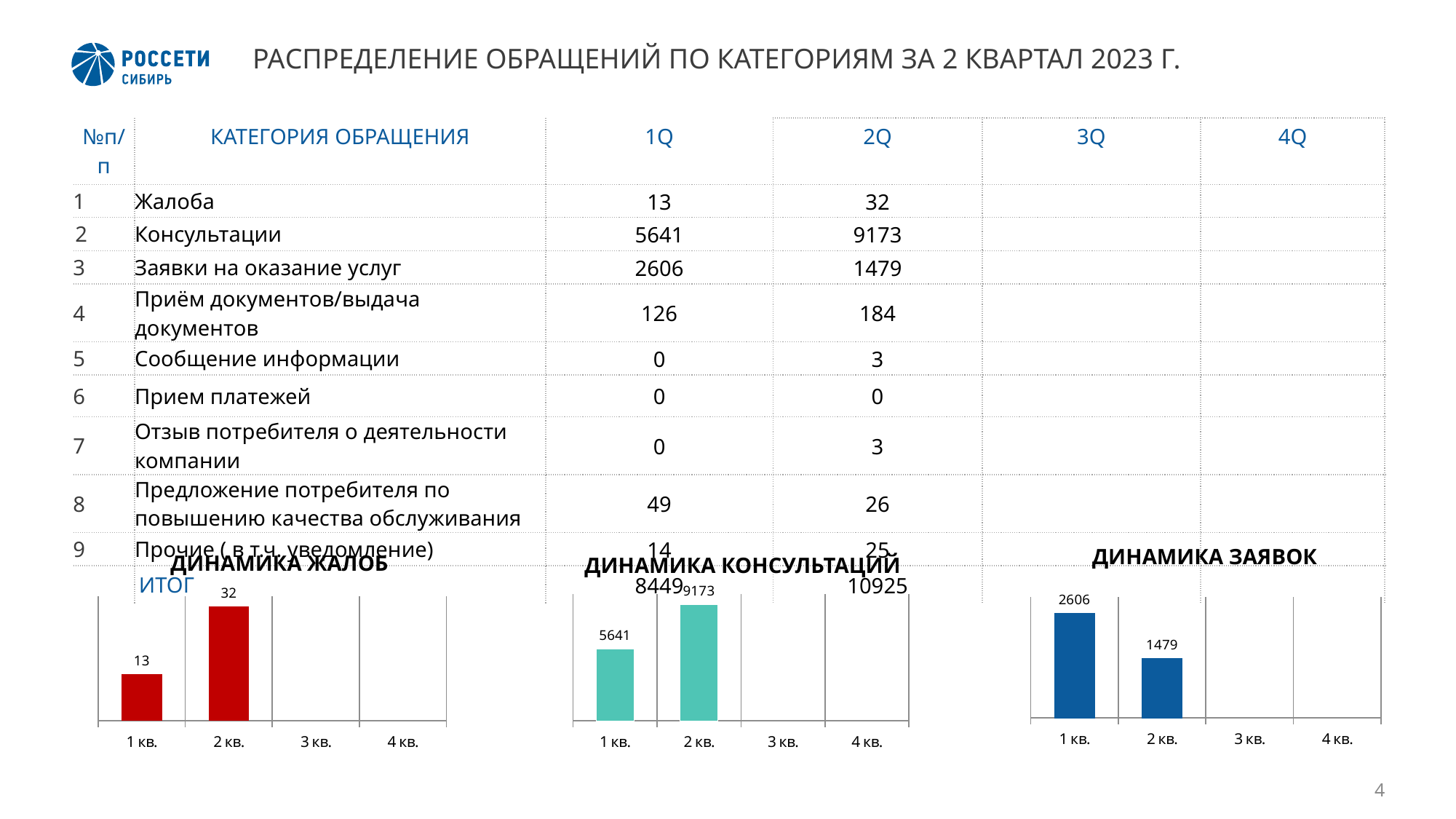
In the chart titled "ДИНАМИКА КОНСУЛЬТАЦИЙ", which quarter has the higher value, 1 кв. or 2 кв.? 2 кв. In the chart titled "ДИНАМИКА ЗАЯВОК", what is the value for 1 кв.? 2606 In the chart titled "ДИНАМИКА ЖАЛОБ", what is the value for 1 кв.? 13 In the chart titled "ДИНАМИКА КОНСУЛЬТАЦИЙ", what is the value for 2 кв.? 9173 In the chart titled "ДИНАМИКА ЗАЯВОК", do the values rise or fall from 1 кв. to 2 кв.? fall In the chart titled "ДИНАМИКА КОНСУЛЬТАЦИЙ", what is the difference between the values for 2 кв. and 1 кв.? 3532 In the chart titled "ДИНАМИКА ЖАЛОБ", what is the value for 2 кв.? 32 In the chart titled "ДИНАМИКА ЖАЛОБ", what is the difference between the values for 2 кв. and 1 кв.? 19 In the chart titled "ДИНАМИКА ЗАЯВОК", what is the value for 2 кв.? 1479 What kind of chart is the chart titled "ДИНАМИКА ЗАЯВОК"? bar chart In the chart titled "ДИНАМИКА КОНСУЛЬТАЦИЙ", what is the value for 1 кв.? 5641 How many quarter categories are shown on the x axis of the chart titled "ДИНАМИКА ЖАЛОБ"? 4